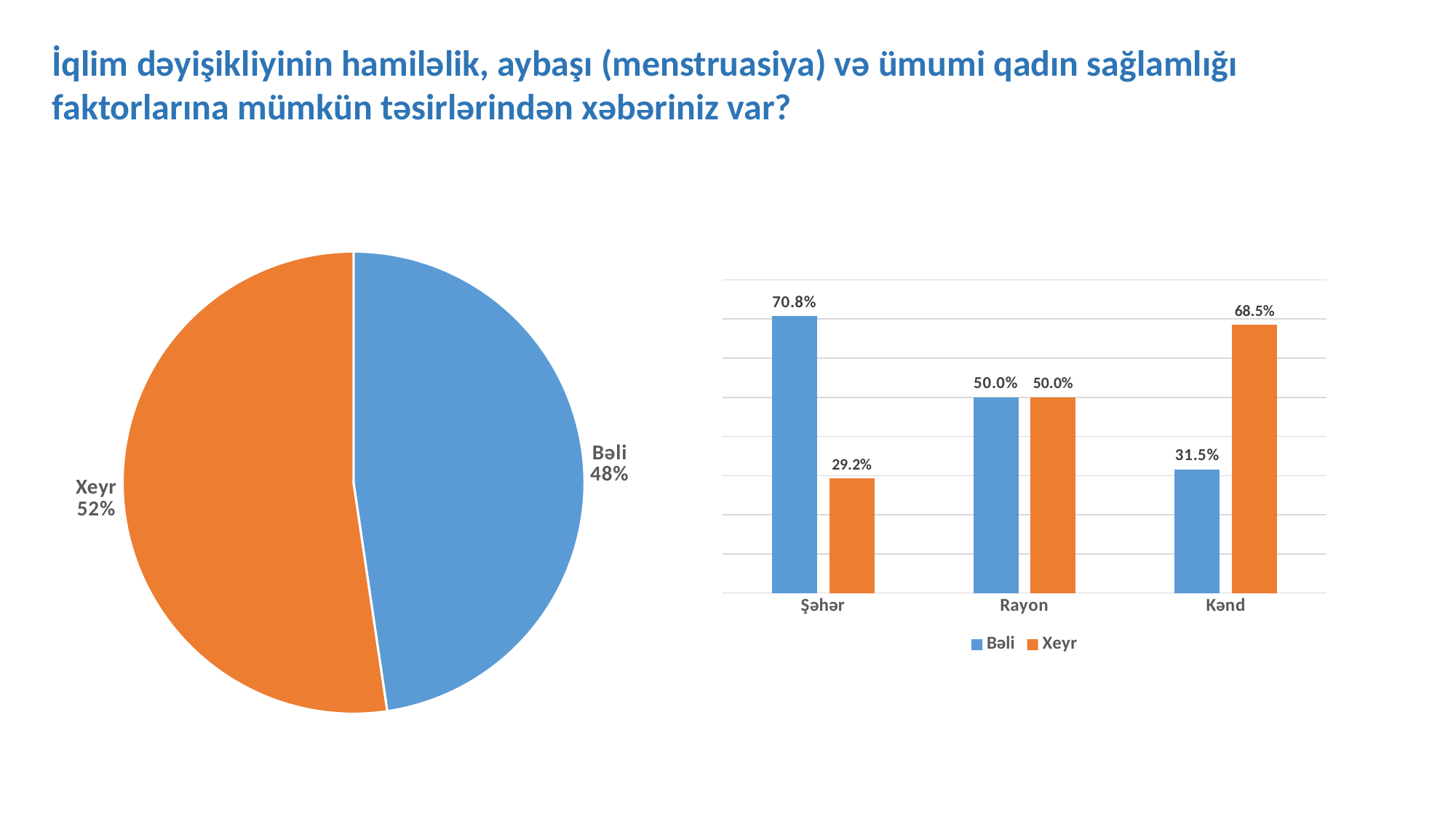
In the bar chart on the right, how many series does the legend list? 2 In the pie chart on the left, which slice is larger, Bəli or Xeyr? Xeyr In the pie chart on the left, how many slices are there? 2 In the bar chart on the right, what is the Xeyr value for Kənd? 68.5% In the bar chart on the right, which category has the lowest Xeyr value? Şəhər In the pie chart on the left, what share is labelled Bəli? 48% In the pie chart on the left, what share is labelled Xeyr? 52% What kind of chart is on the right of the slide? Bar chart In the bar chart on the right, what is the Bəli value for Şəhər? 70.8% In the bar chart on the right, what is the difference between the Bəli and Xeyr values for Şəhər? 41.6% What kind of chart is on the left of the slide? Pie chart In the bar chart on the right, which category has the highest Bəli value? Şəhər